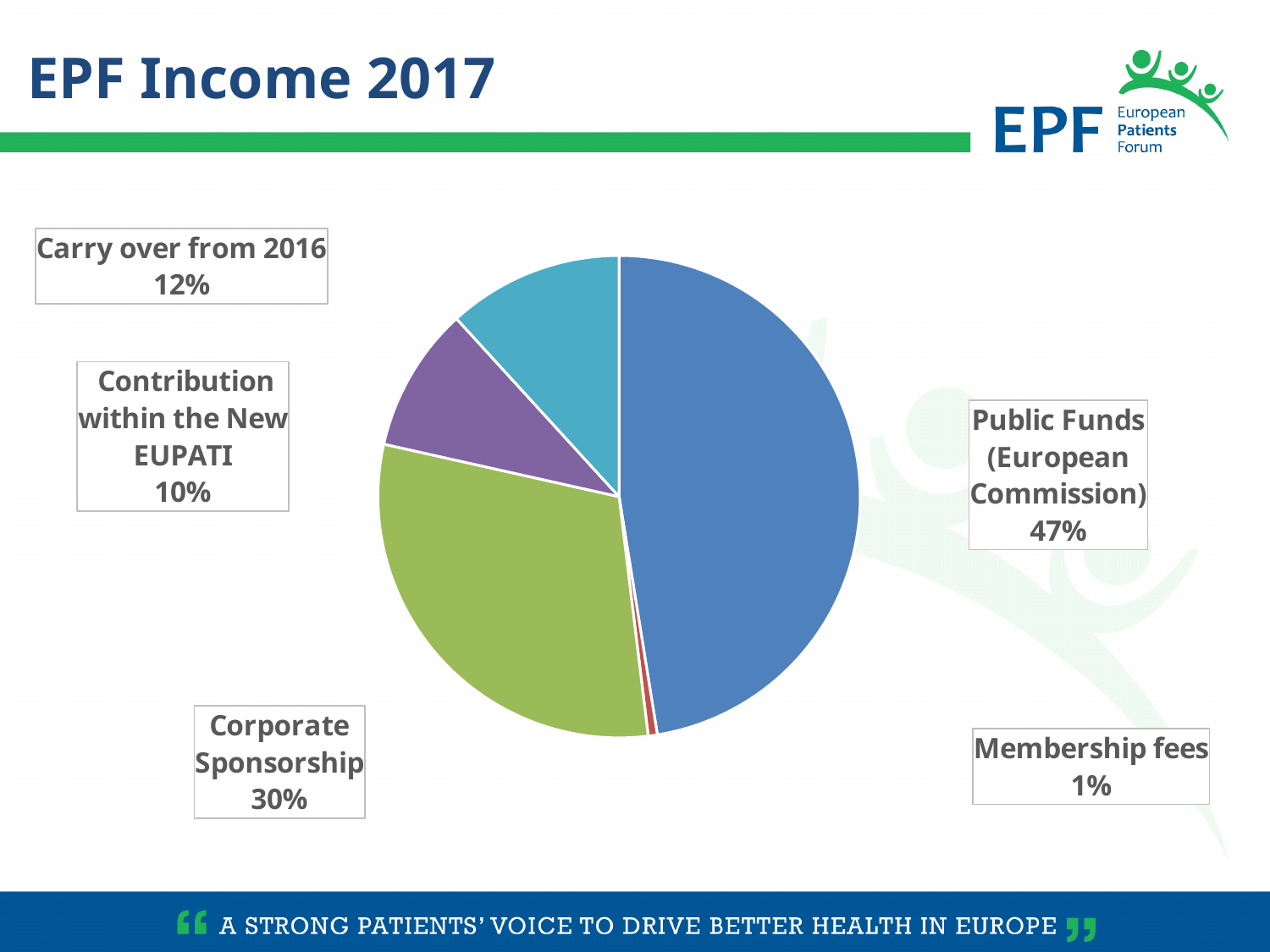
What is the title of the slide? EPF Income 2017 What share of income was Carry over from 2016? 12% What share of income was the Contribution within the New EUPATI? 10% Which income source has the smallest share? Membership fees What percentage of income came from Membership fees? 1% What percentage of income came from Corporate Sponsorship? 30% Which income source has the largest share? Public Funds (European Commission) What is the difference in percentage points between Public Funds (European Commission) and Corporate Sponsorship? 17 What type of chart is shown on the slide? pie chart What share of EPF income in 2017 came from Public Funds (European Commission)? 47% Which is larger, Carry over from 2016 or Contribution within the New EUPATI? Carry over from 2016 How many income categories are shown in the pie chart? 5